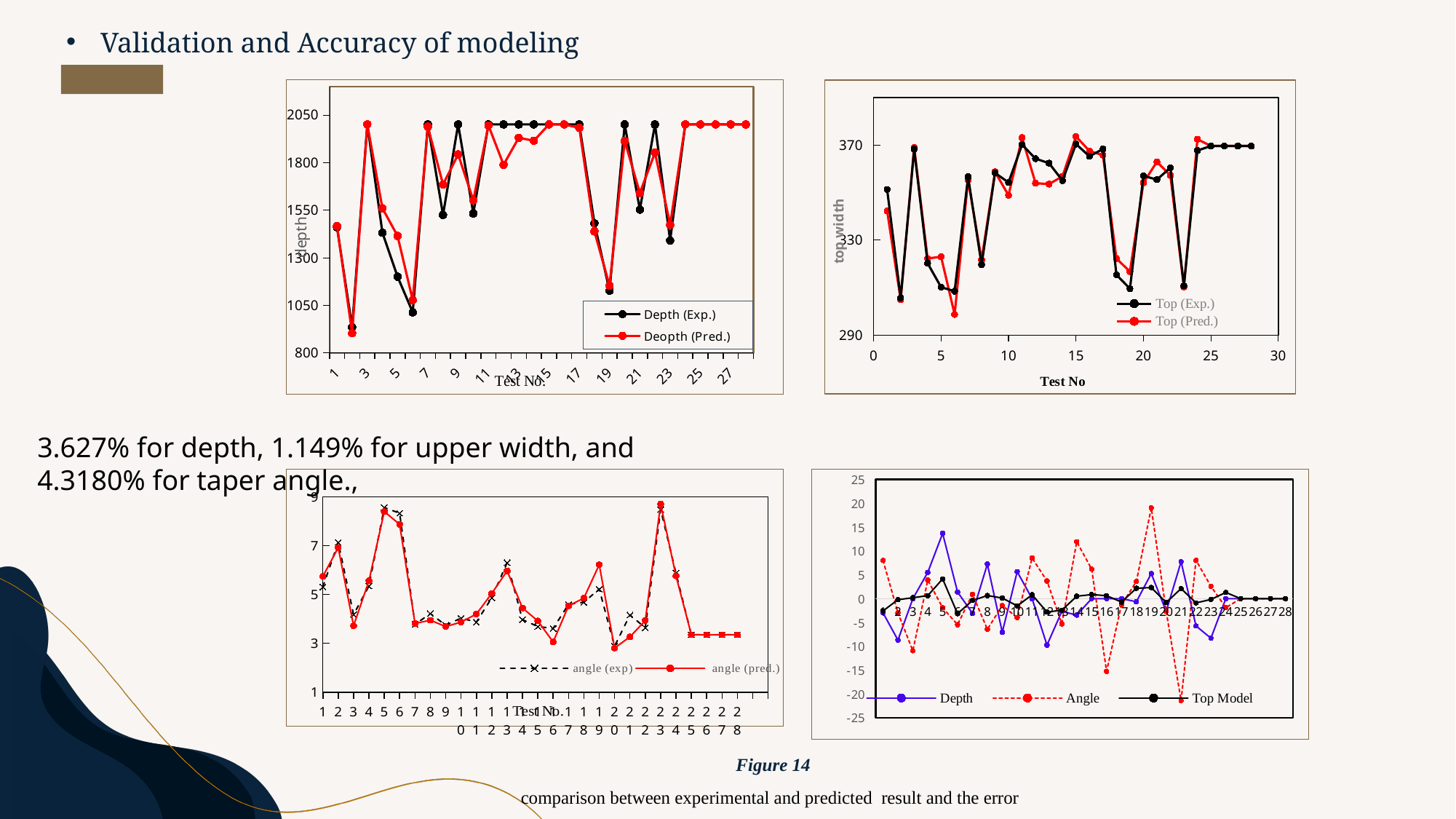
In the top-right chart (top width), is the Top (Exp.) value at test 23 greater or less than 330? less What kind of chart is the top-left chart (depth vs. Test No.)? line chart In the top-left chart (depth), is the Depth (Exp.) value at test 6 greater or less than 1050? less How many series does the legend of the bottom-left chart (angle) list? 2 How many test numbers are plotted along the x axis of the bottom-left chart (angle)? 28 In the bottom-left chart (angle), is the angle (pred.) value at test 23 greater or less than 7? greater What are the two legend entries of the top-left chart (depth)? Depth (Exp.) and Deopth (Pred.) How many series does the legend of the top-right chart (top width) list? 2 In the bottom-right chart (error), which series reaches the highest value? Angle How many series does the legend of the bottom-right chart (error) list? 3